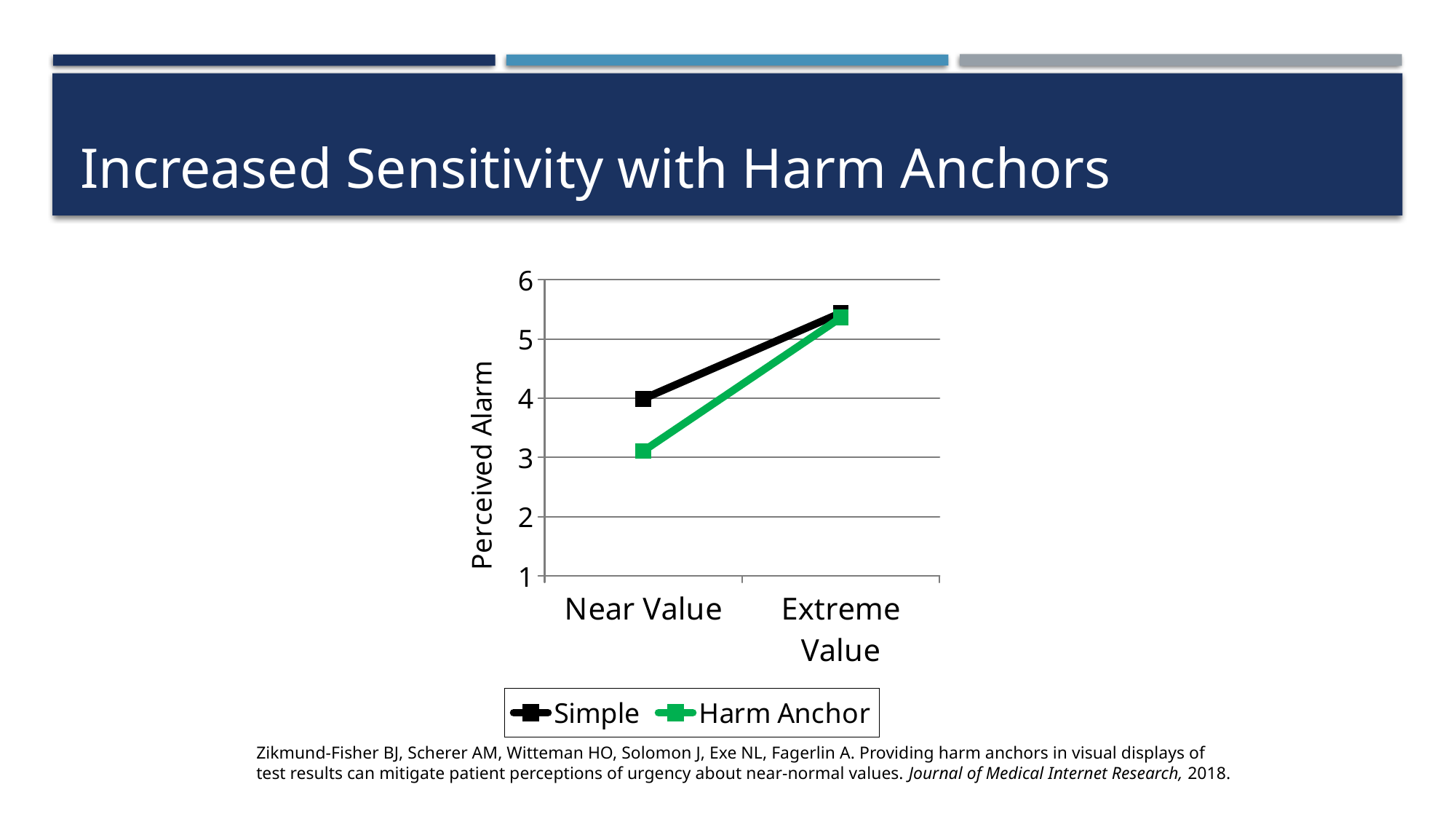
For the Harm Anchor series, which category has the lowest Perceived Alarm? Near Value Does the Simple series rise or fall from Near Value to Extreme Value? Rise What kind of chart is shown on the slide? Line chart What colour is the Harm Anchor line? Green How many series does the legend list? 2 Is the Simple value at Extreme Value greater or less than 5? greater Is the Harm Anchor value at Extreme Value greater or less than 5? greater At Near Value, which series has the higher Perceived Alarm, Simple or Harm Anchor? Simple Is the Harm Anchor value at Near Value greater or less than 4? less Does the Harm Anchor series rise or fall from Near Value to Extreme Value? Rise How many categories are shown on the x axis? 2 What is the label of the y axis? Perceived Alarm